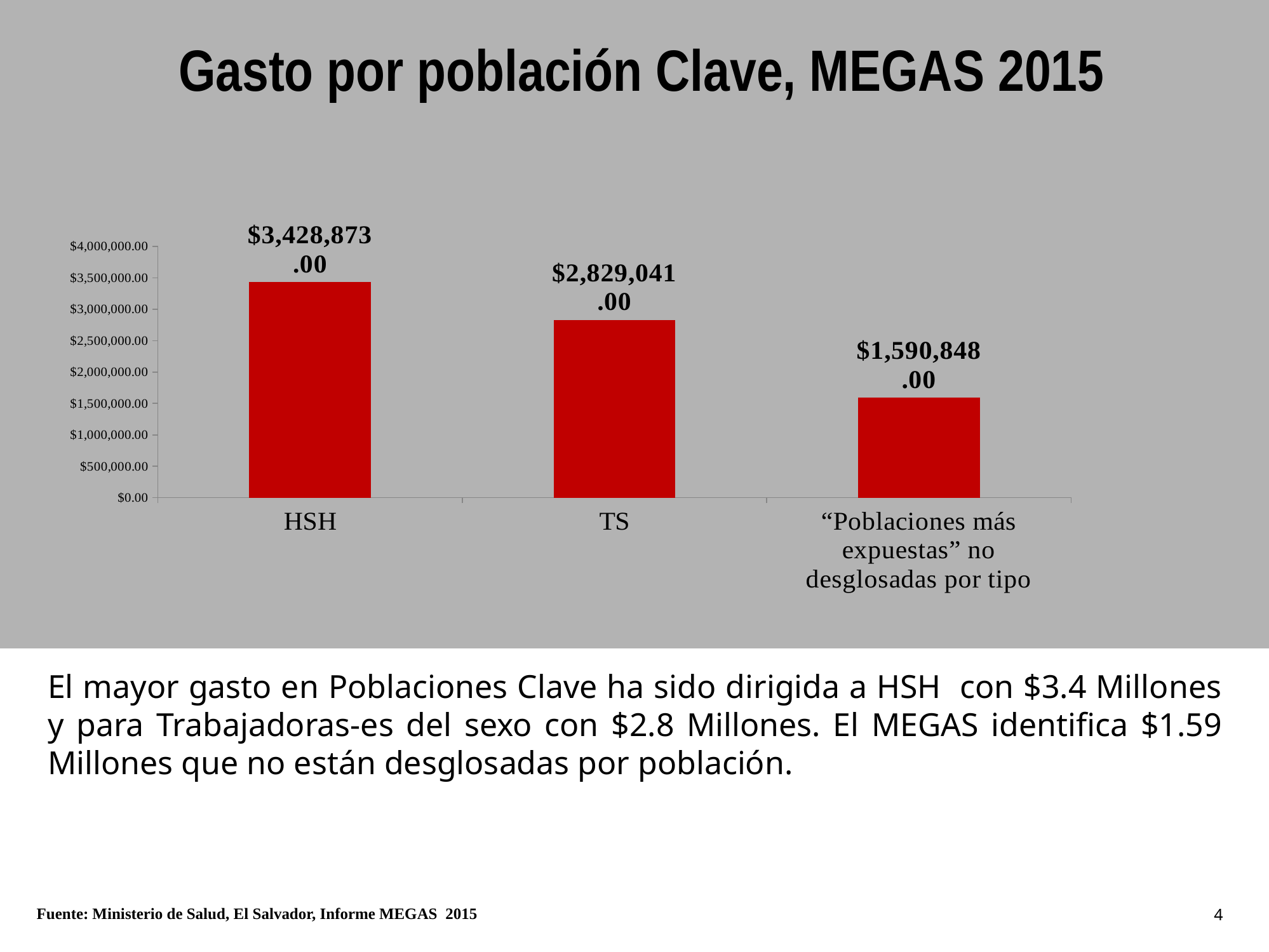
What is the value for HSH? $3,428,873.00 What kind of chart is shown on the slide? bar chart What is the difference between the values for TS and "Poblaciones más expuestas" no desglosadas por tipo? $1,238,193.00 What is the value for TS? $2,829,041.00 Which is larger, the value for HSH or the value for TS? HSH What is the value for "Poblaciones más expuestas" no desglosadas por tipo? $1,590,848.00 How many categories are shown in the chart? 3 Which category has the highest value? HSH What is the title of the slide containing the chart? Gasto por población Clave, MEGAS 2015 Is the value for TS greater or less than $2,500,000.00? greater What is the difference between the values for HSH and TS? $599,832.00 Which category has the lowest value? "Poblaciones más expuestas" no desglosadas por tipo